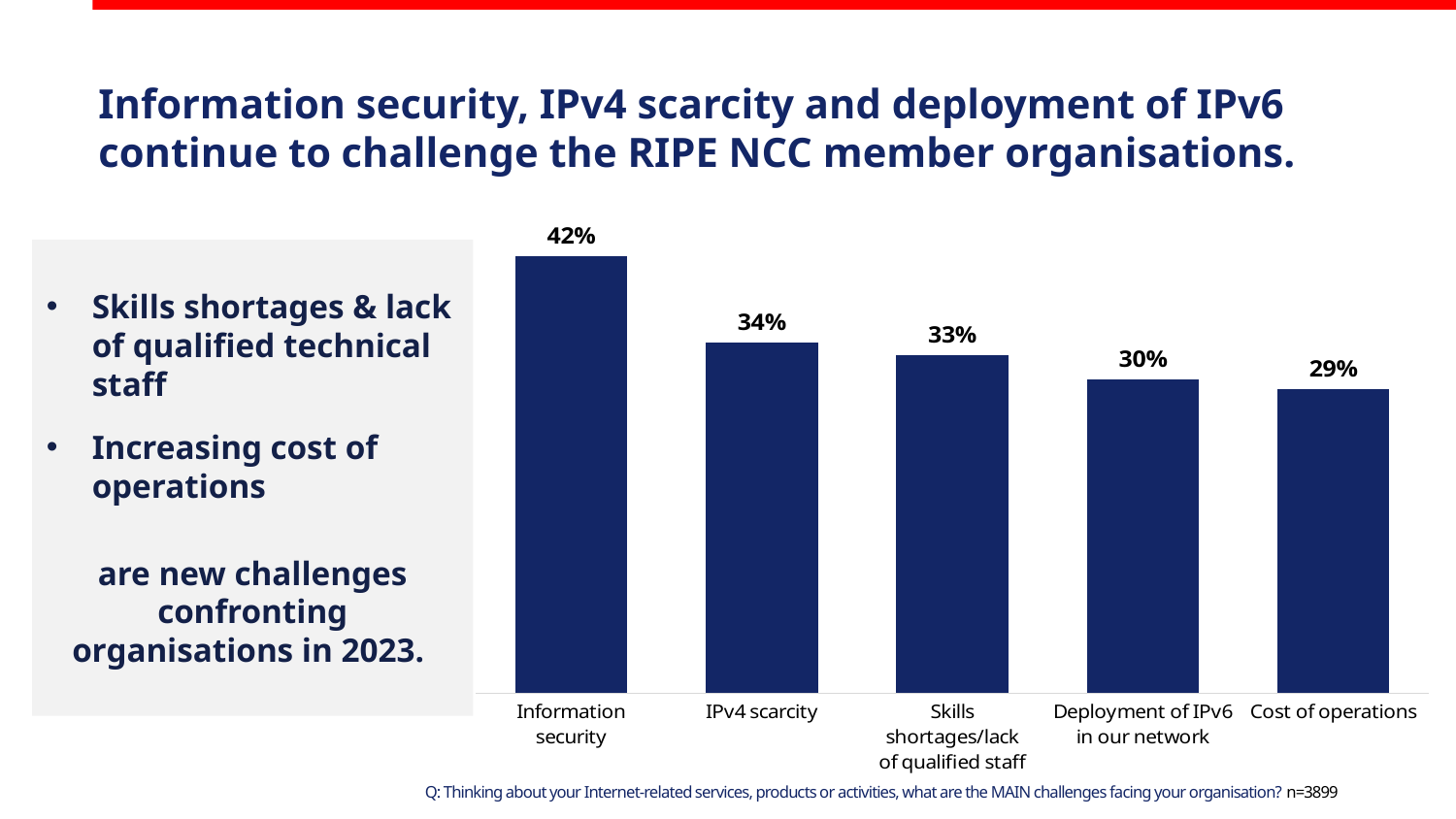
Which challenge has the lowest percentage? Cost of operations What percentage of respondents cited Information security as a main challenge? 42% Which is larger, the value for Information security or the value for Deployment of IPv6 in our network? Information security What is the difference in percentage points between Information security and IPv4 scarcity? 8 What type of chart is shown on the slide? Bar chart What is the value shown for Cost of operations? 29% What is the difference in percentage points between Deployment of IPv6 in our network and Cost of operations? 1 What is the value shown for Skills shortages/lack of qualified staff? 33% What is the value shown for IPv4 scarcity? 34% How many challenge categories are shown in the chart? 5 Which challenge has the highest percentage? Information security Do the values rise or fall from left to right across the categories? Fall